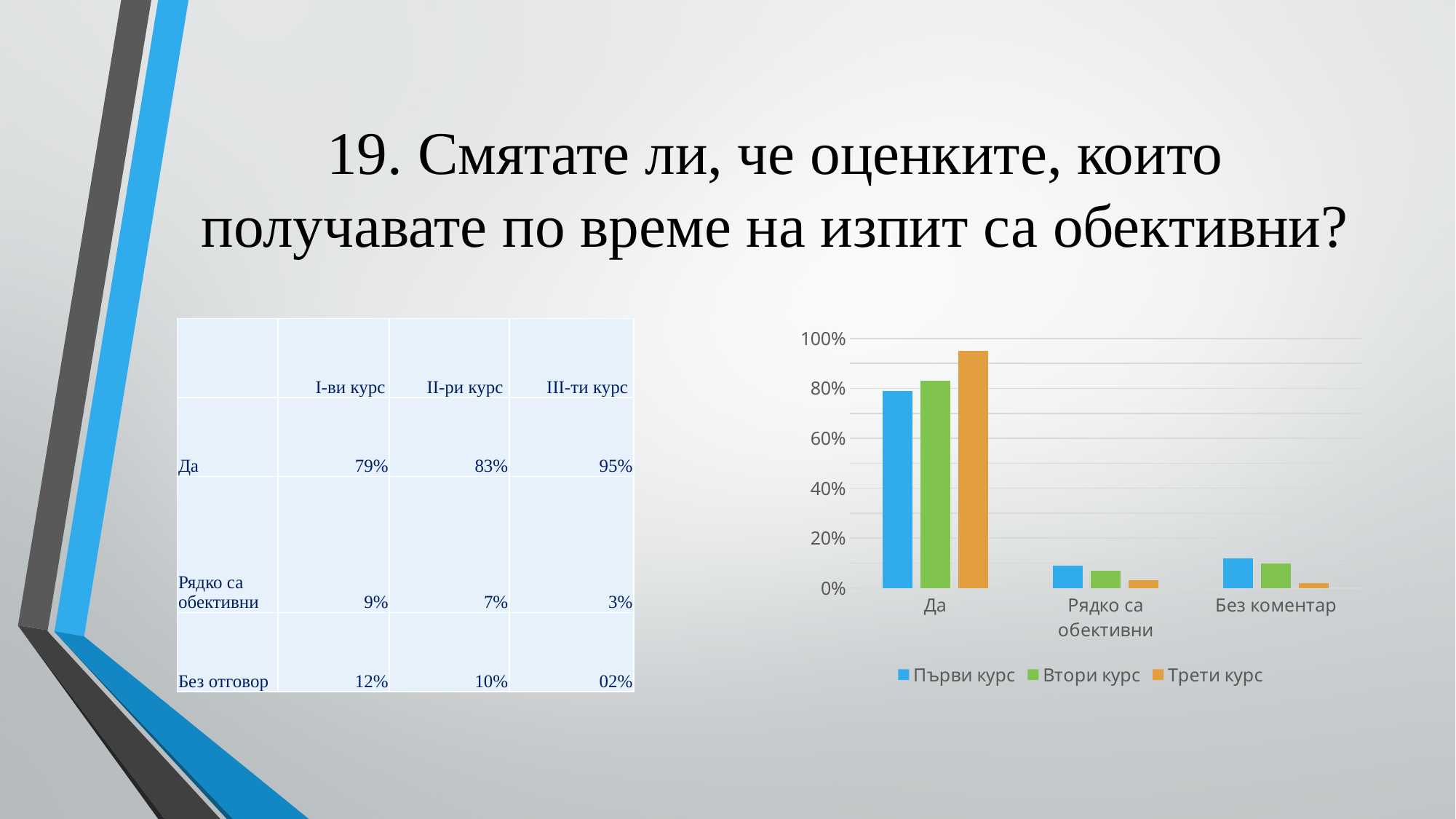
What kind of chart is shown on the slide? bar chart What colour are the bars for the series Трети курс? orange Which series has the tallest bar for the category Да? Трети курс Which is larger for the category Без коментар: Първи курс or Трети курс? Първи курс Is the value for Втори курс in the category Да greater or less than 80%? greater What is the value for Първи курс in the category Да? 79% What is the value for Трети курс in the category Да? 95% How many series does the chart legend list? 3 Which category has the highest values in the chart? Да How many categories are shown on the x axis of the chart? 3 What is the value for Втори курс in the category Рядко са обективни? 7% What is the difference between the Трети курс and Първи курс values for the category Да? 16%